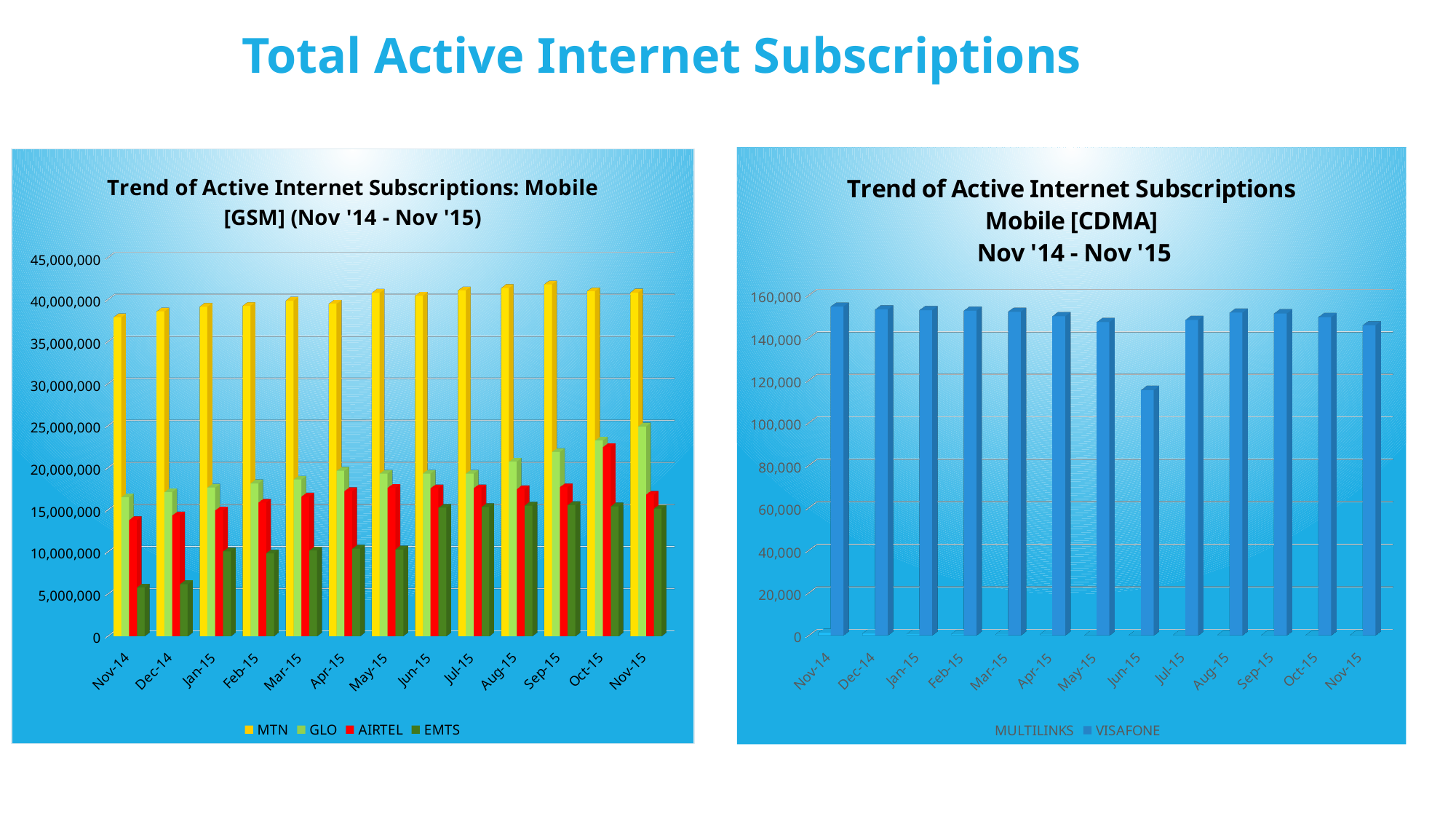
How many months are shown on the x axis of the left chart (Mobile [GSM])? 13 In the right chart (Mobile [CDMA]), is the value for Jun-15 greater or less than 120,000? less In the left chart (Mobile [GSM]), do EMTS subscriptions rise or fall from Nov-14 to Nov-15? Rise How many series does the legend of the right chart (Mobile [CDMA]) list? 2 What type of chart is the left chart, 'Trend of Active Internet Subscriptions: Mobile [GSM]'? Bar chart In the left chart (Mobile [GSM]), is the MTN value for Nov-14 greater or less than 35,000,000? greater In the right chart (Mobile [CDMA]), which month has the lowest value? Jun-15 In the left chart (Mobile [GSM]), is the EMTS value for Nov-14 greater or less than 10,000,000? less In the left chart (Mobile [GSM]), which operator has the highest subscriptions in Nov-15? MTN In the left chart (Mobile [GSM]), which is larger in Nov-15, GLO or AIRTEL? GLO In the left chart (Mobile [GSM]), which operator has the lowest subscriptions in Nov-14? EMTS How many series does the legend of the left chart (Mobile [GSM]) list? 4